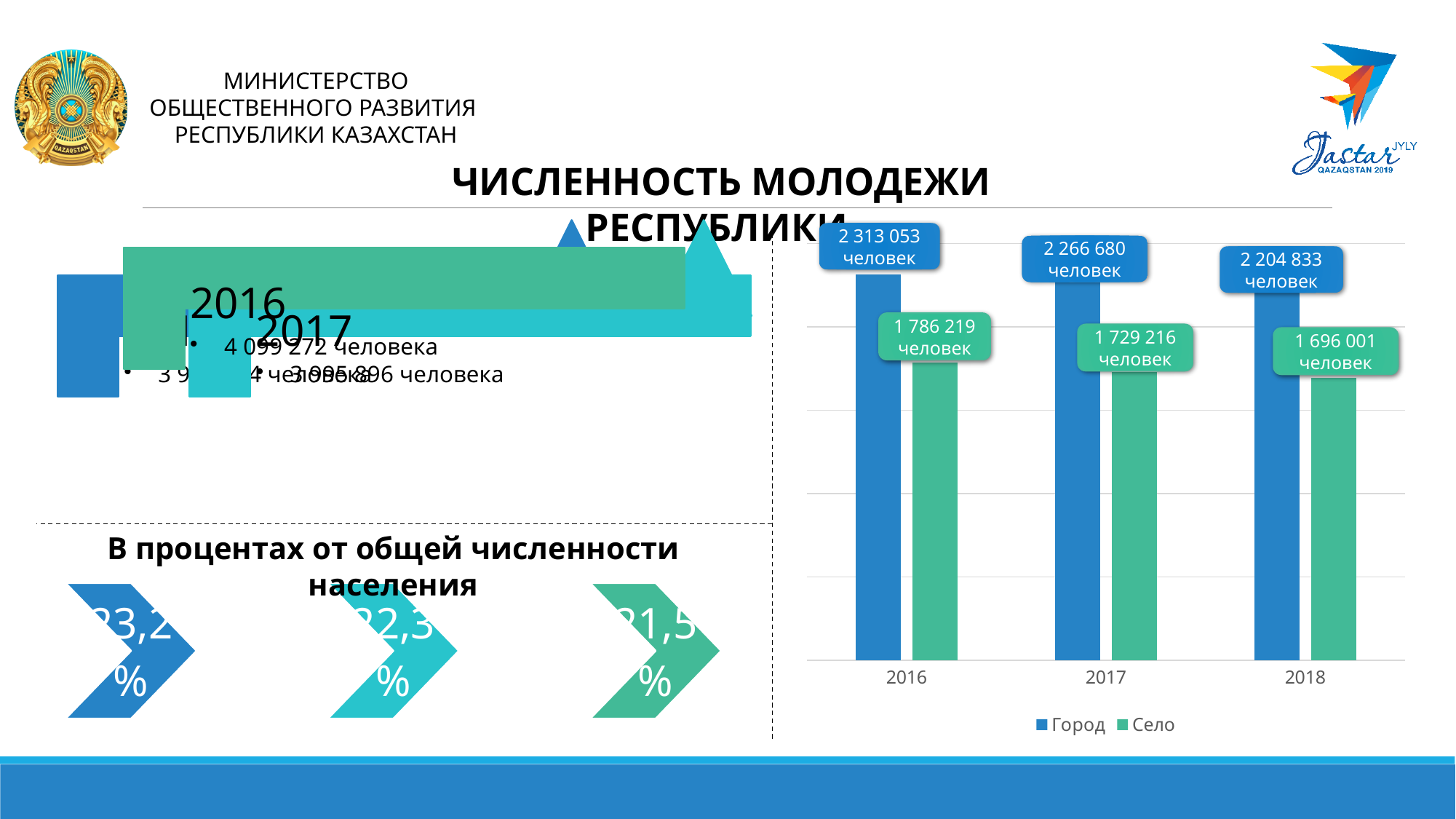
In which year is the Село value lowest in the bar chart? 2018 What is the value for Село in 2017 in the bar chart? 1 729 216 человек How many series does the legend of the bar chart list? 2 What is the value for Село in 2018 in the bar chart? 1 696 001 человек What is the difference between Город and Село in 2018 in the bar chart? 508 832 In which year is the Город value highest in the bar chart? 2016 What type of chart is shown on the right side of the slide? bar chart What are the two series named in the legend of the bar chart? Город and Село Do the Город values rise or fall from 2016 to 2018 in the bar chart? fall Which is larger in 2017 in the bar chart, Город or Село? Город What is the value for Город in 2016 in the bar chart? 2 313 053 человек How many years are shown on the x axis of the bar chart? 3